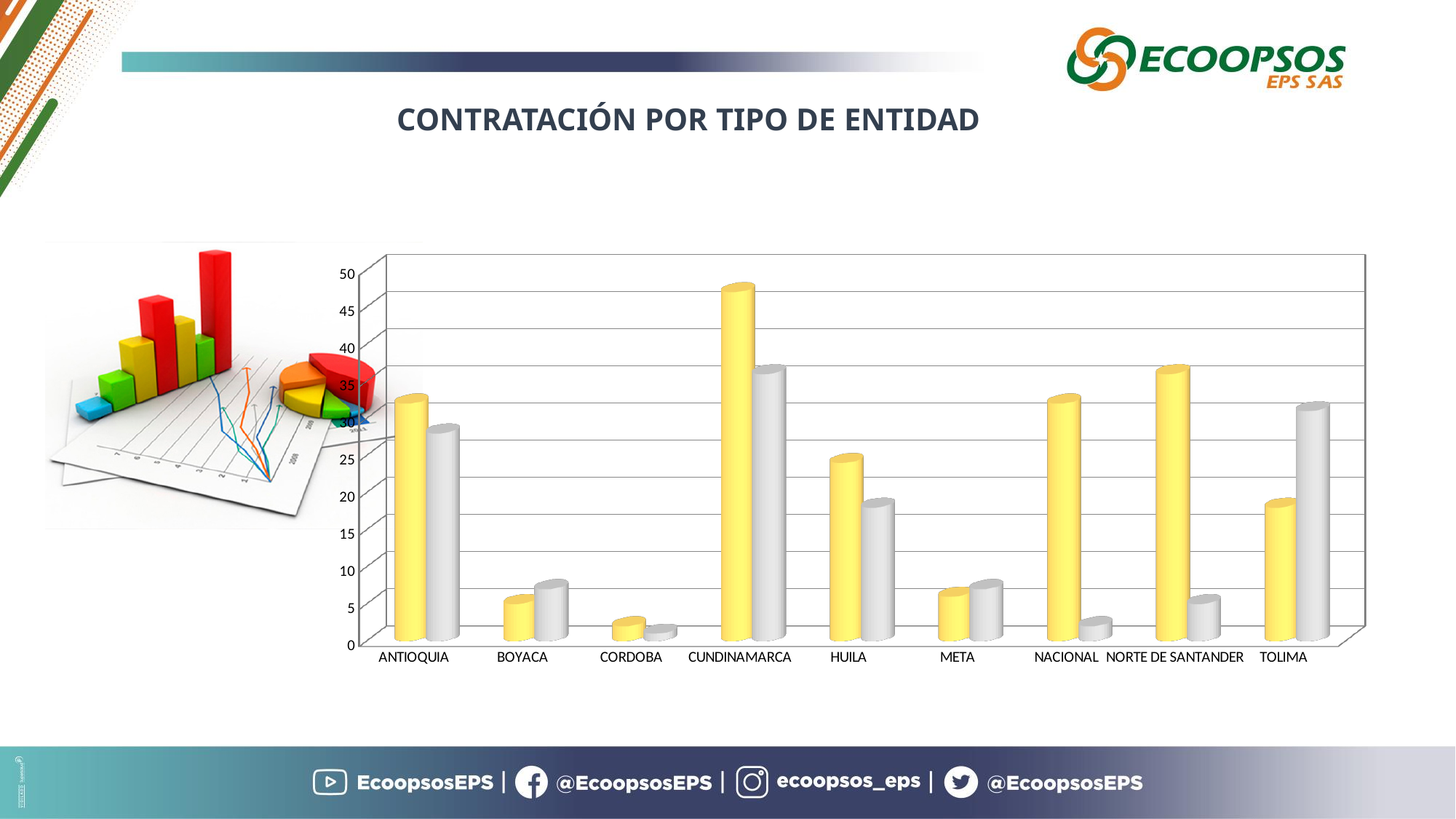
Which category has the shortest grey bar? CORDOBA Which category has the tallest yellow bar? CUNDINAMARCA Is the grey bar for NACIONAL greater or less than 5? less What kind of chart is shown on the slide? Bar chart Which category has the tallest grey bar? CUNDINAMARCA Is the grey bar for TOLIMA greater or less than 25? greater How many categories are shown on the x axis of the chart? 9 For TOLIMA, which bar is taller, the yellow one or the grey one? The grey one Which category has the shortest yellow bar? CORDOBA Is the yellow bar for CUNDINAMARCA greater or less than 40? greater For NORTE DE SANTANDER, which bar is taller, the yellow one or the grey one? The yellow one